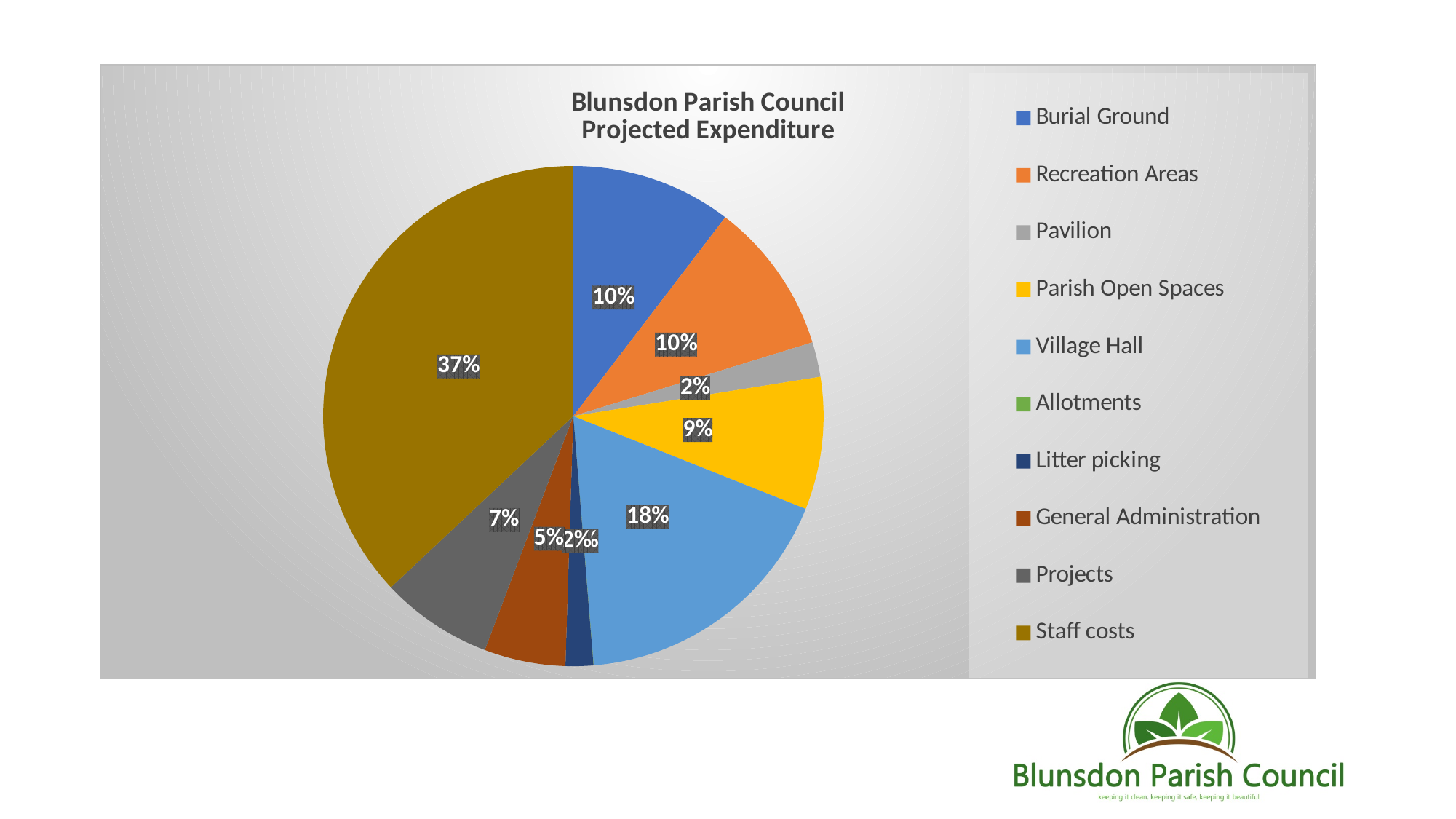
What percentage of the pie is Village Hall? 18% What kind of chart is shown on the slide? Pie chart How many categories does the legend list? 10 How many percentage points larger is the Staff costs share than the Village Hall share? 19 percentage points What share does Parish Open Spaces have? 9% Which is larger, the share for Village Hall or the share for Burial Ground? Village Hall What share of projected expenditure is Staff costs? 37% What is the title of the chart? Blunsdon Parish Council Projected Expenditure What percentage is shown for Pavilion? 2% What share of projected expenditure is Projects? 7% Which category has the largest share of projected expenditure? Staff costs What percentage is shown for General Administration? 5%